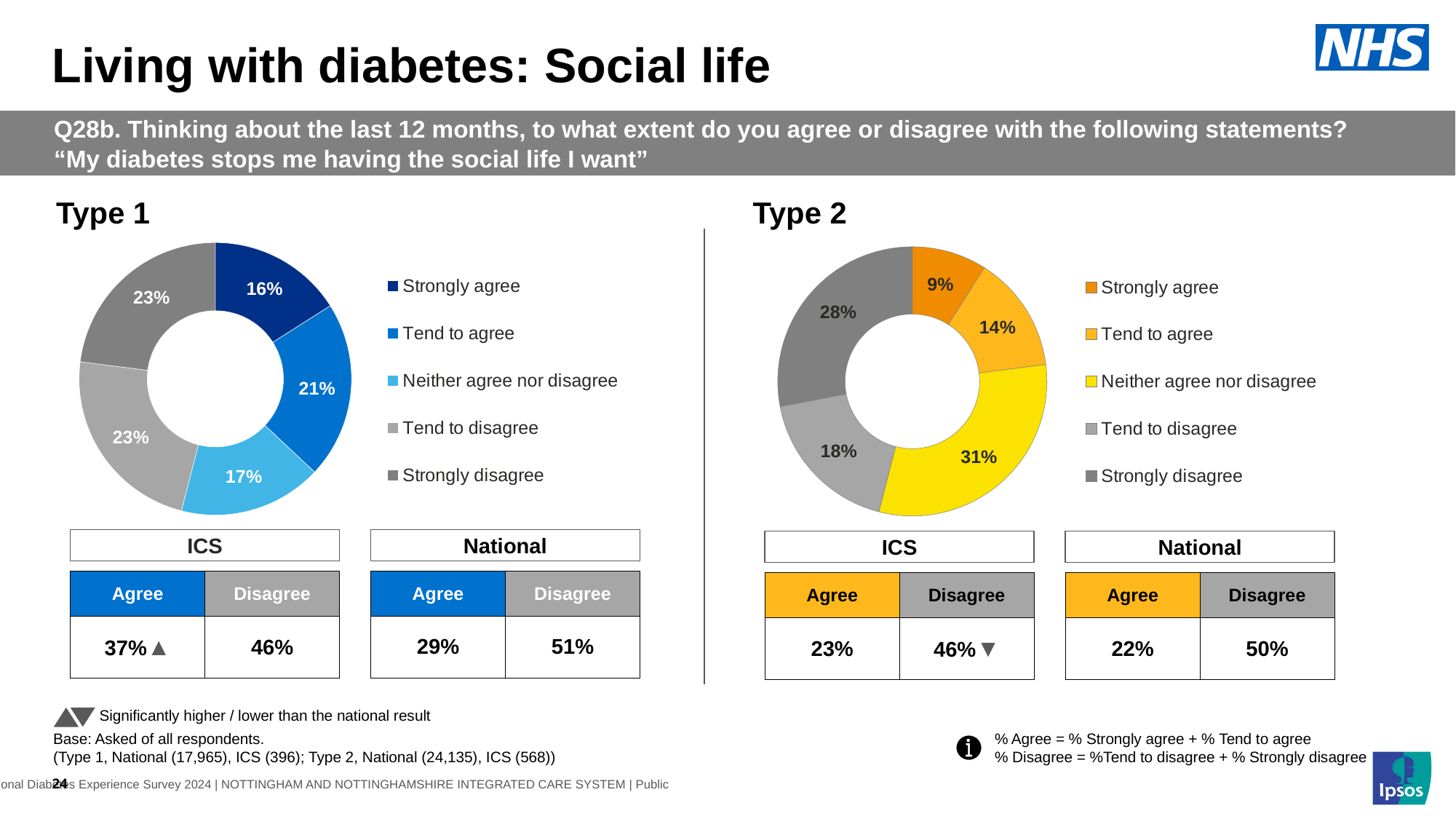
In the Type 1 chart, what percentage of respondents said 'Neither agree nor disagree'? 17% In the Type 2 chart, which response category has the smallest share? Strongly agree What kind of chart is used to show the Type 1 results? Donut (pie) chart In the Type 2 chart, what percentage of respondents said 'Neither agree nor disagree'? 31% How many response categories does the legend of the Type 1 chart list? 5 In the Type 1 chart, what is the difference between the 'Tend to agree' and 'Strongly agree' percentages? 5% In the Type 2 chart, what is the difference between the 'Strongly disagree' and 'Tend to disagree' percentages? 10% In the Type 2 chart, which response category has the largest share? Neither agree nor disagree In the Type 2 chart, which is larger: 'Tend to agree' or 'Tend to disagree'? Tend to disagree In the Type 1 chart, what percentage of respondents said 'Strongly agree'? 16% In the Type 2 chart, what percentage of respondents said 'Strongly agree'? 9% In the Type 1 chart, which response category has the smallest share? Strongly agree